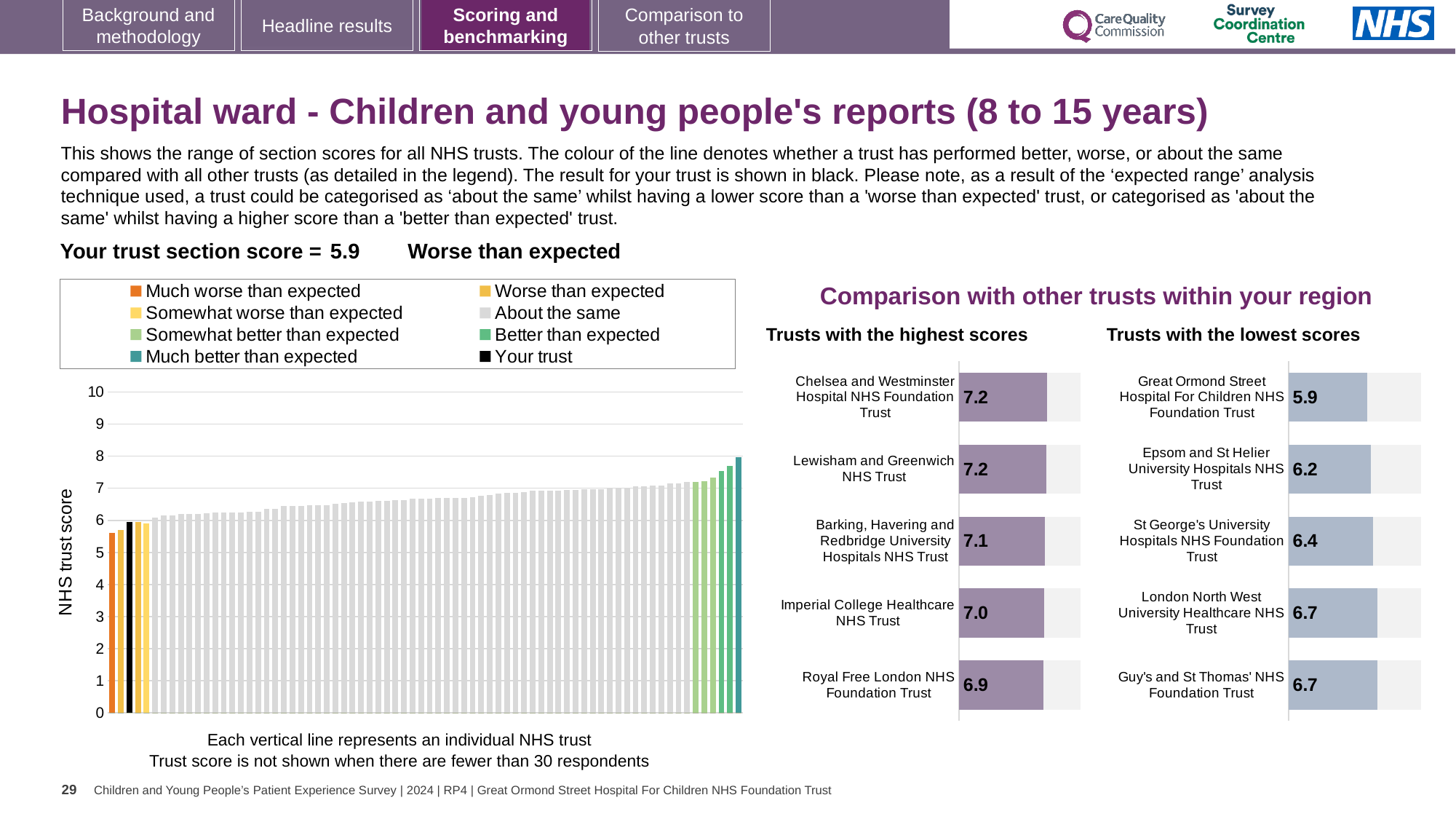
In the 'Trusts with the highest scores' chart, how many trusts are listed? 5 In the 'Trusts with the lowest scores' chart, what is the difference between the scores of Guy's and St Thomas' NHS Foundation Trust and Great Ormond Street Hospital For Children NHS Foundation Trust? 0.8 In the 'Trusts with the highest scores' chart, which trust has the lowest score? Royal Free London NHS Foundation Trust In the 'Trusts with the highest scores' chart, what is the score for Imperial College Healthcare NHS Trust? 7.0 In the 'Trusts with the lowest scores' chart, which trust has the lowest score? Great Ormond Street Hospital For Children NHS Foundation Trust In the large chart on the left, do the NHS trust scores rise or fall from left to right? Rise In the 'Trusts with the lowest scores' chart, what is the score for Great Ormond Street Hospital For Children NHS Foundation Trust? 5.9 In the 'Trusts with the highest scores' chart, what is the difference between the scores of Chelsea and Westminster Hospital NHS Foundation Trust and Royal Free London NHS Foundation Trust? 0.3 In the 'Trusts with the highest scores' chart, what is the score for Chelsea and Westminster Hospital NHS Foundation Trust? 7.2 In the 'Trusts with the lowest scores' chart, which has the higher score: Epsom and St Helier University Hospitals NHS Trust or St George's University Hospitals NHS Foundation Trust? St George's University Hospitals NHS Foundation Trust How many entries does the legend of the large chart on the left list? 8 What type of chart is the large chart on the left showing NHS trust scores? Bar chart